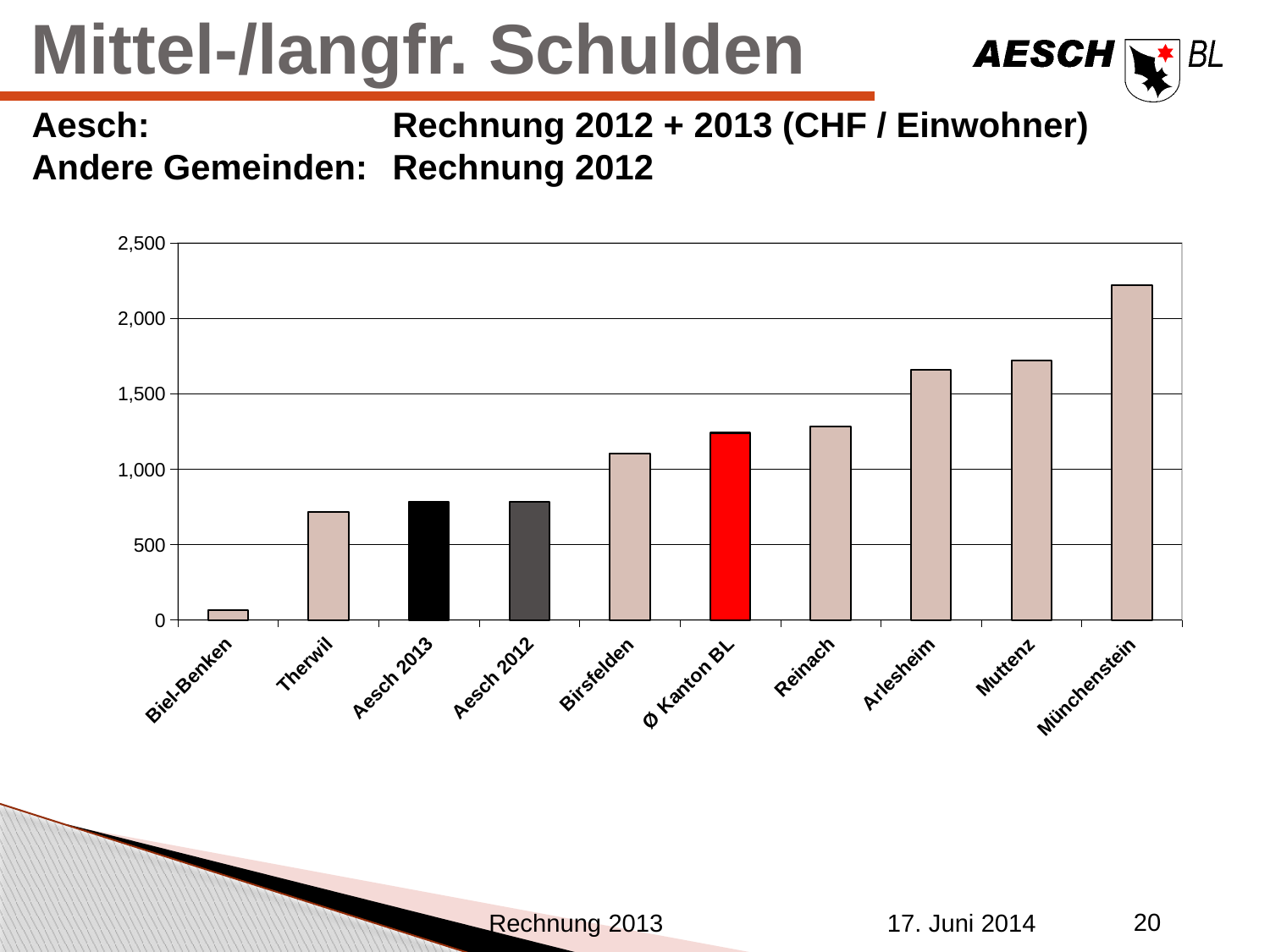
Which category has the lowest value in the chart? Biel-Benken Which category has the highest value in the chart? Münchenstein Is the value for Biel-Benken greater or less than 500? less Is the value for Birsfelden greater or less than 1,000? greater Is the value for Therwil greater or less than 1,000? less What kind of chart is shown on the slide? bar chart Which has a larger value, Arlesheim or Birsfelden? Arlesheim Do the values generally rise or fall from left to right along the x axis? rise How many categories are shown on the x axis of the chart? 10 What colour is the bar for Ø Kanton BL? red